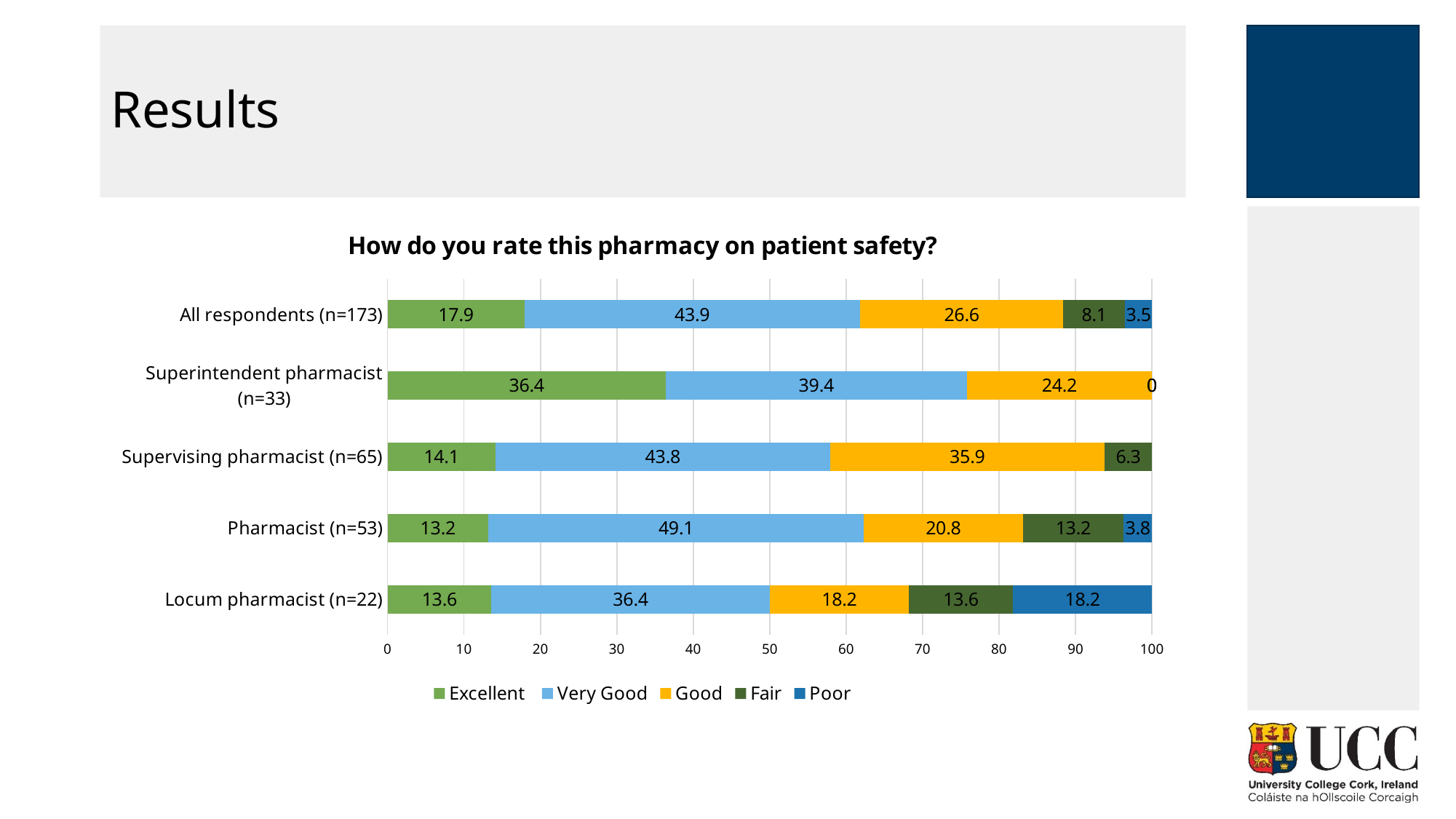
Which category has the highest Excellent value? Superintendent pharmacist (n=33) Which is larger: the Excellent value for Supervising pharmacist (n=65) or for Pharmacist (n=53)? Supervising pharmacist (n=65) What is the Very Good value for Pharmacist (n=53)? 49.1 How many series does the legend list? 5 Which category has the highest Poor value? Locum pharmacist (n=22) Which category has the lowest Very Good value? Locum pharmacist (n=22) What is the difference between the Very Good and Excellent values for All respondents (n=173)? 26 What is the difference between the Good value for Supervising pharmacist (n=65) and the Good value for Pharmacist (n=53)? 15.1 How many respondent categories are shown on the chart? 5 What is the Excellent value for Superintendent pharmacist (n=33)? 36.4 What is the Fair value for All respondents (n=173)? 8.1 What is the Poor value for Locum pharmacist (n=22)? 18.2